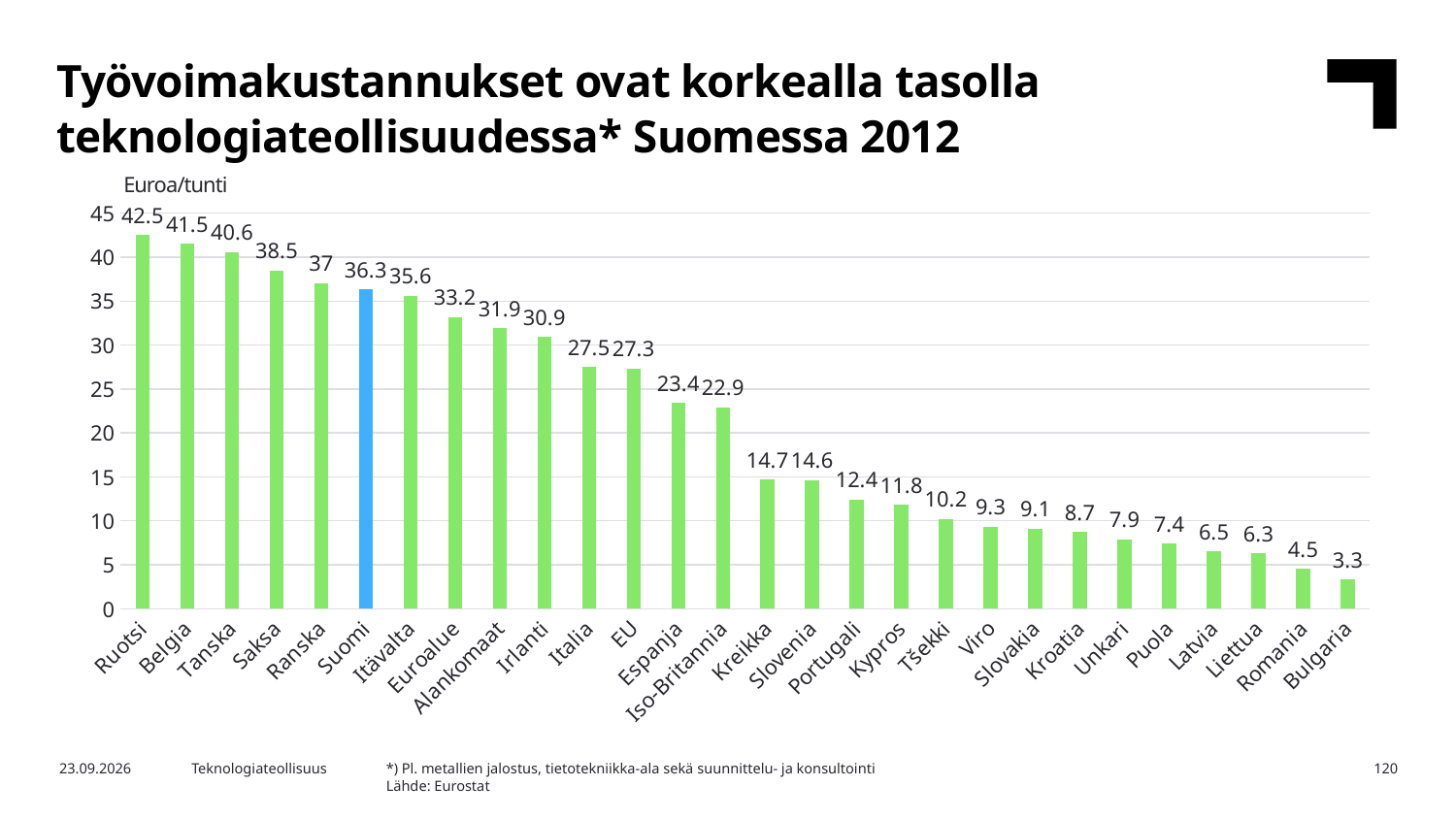
Which bar is coloured differently (blue) from the others? Suomi What is the value for Bulgaria? 3.3 Do the values rise or fall from left to right along the x axis? Fall Which country has the highest labour cost per hour? Ruotsi How many countries or regions are shown on the chart? 28 What is the value for EU? 27.3 What is the value for Saksa? 38.5 What kind of chart is shown on the slide? Bar chart What is the value for Suomi? 36.3 What is the difference between the values for Ruotsi and Suomi? 6.2 Which is larger, the value for Espanja or the value for Kreikka? Espanja Which country has the lowest labour cost per hour? Bulgaria